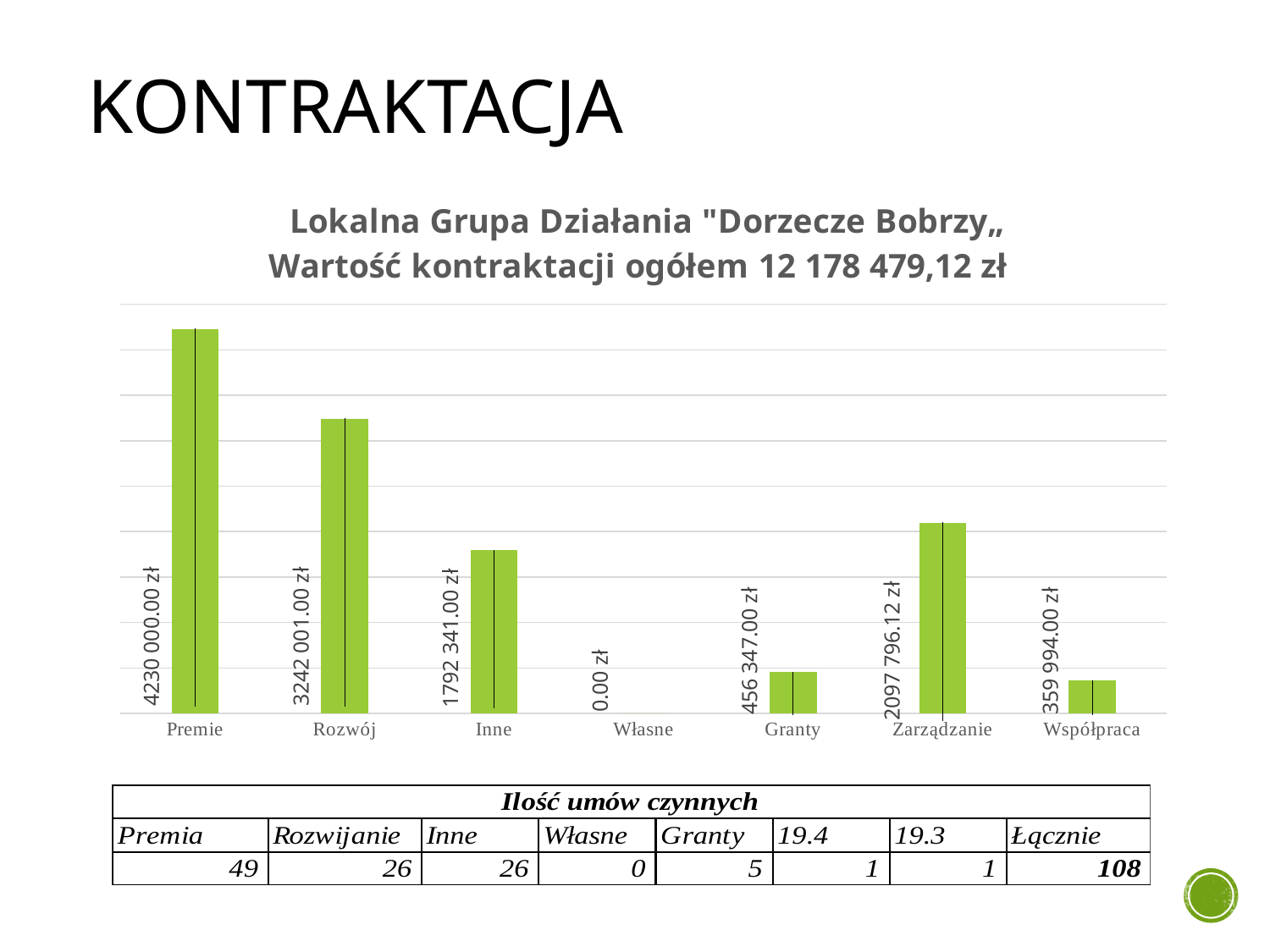
What is the value for Granty? 456 347.00 zł Which is larger, the value for Inne or the value for Zarządzanie? Zarządzanie What is the value for Zarządzanie? 2097 796.12 zł How many categories are shown on the x axis of the chart? 7 What is the difference between the values for Premie and Rozwój? 987 999.00 zł What total contract value (Wartość kontraktacji ogółem) is stated in the chart title? 12 178 479,12 zł What is the value for Własne? 0.00 zł Which category has the lowest value? Własne What kind of chart is shown on the slide? Bar chart Which category has the highest value? Premie What is the value for Premie? 4230 000.00 zł What is the difference between the values for Granty and Współpraca? 96 353.00 zł